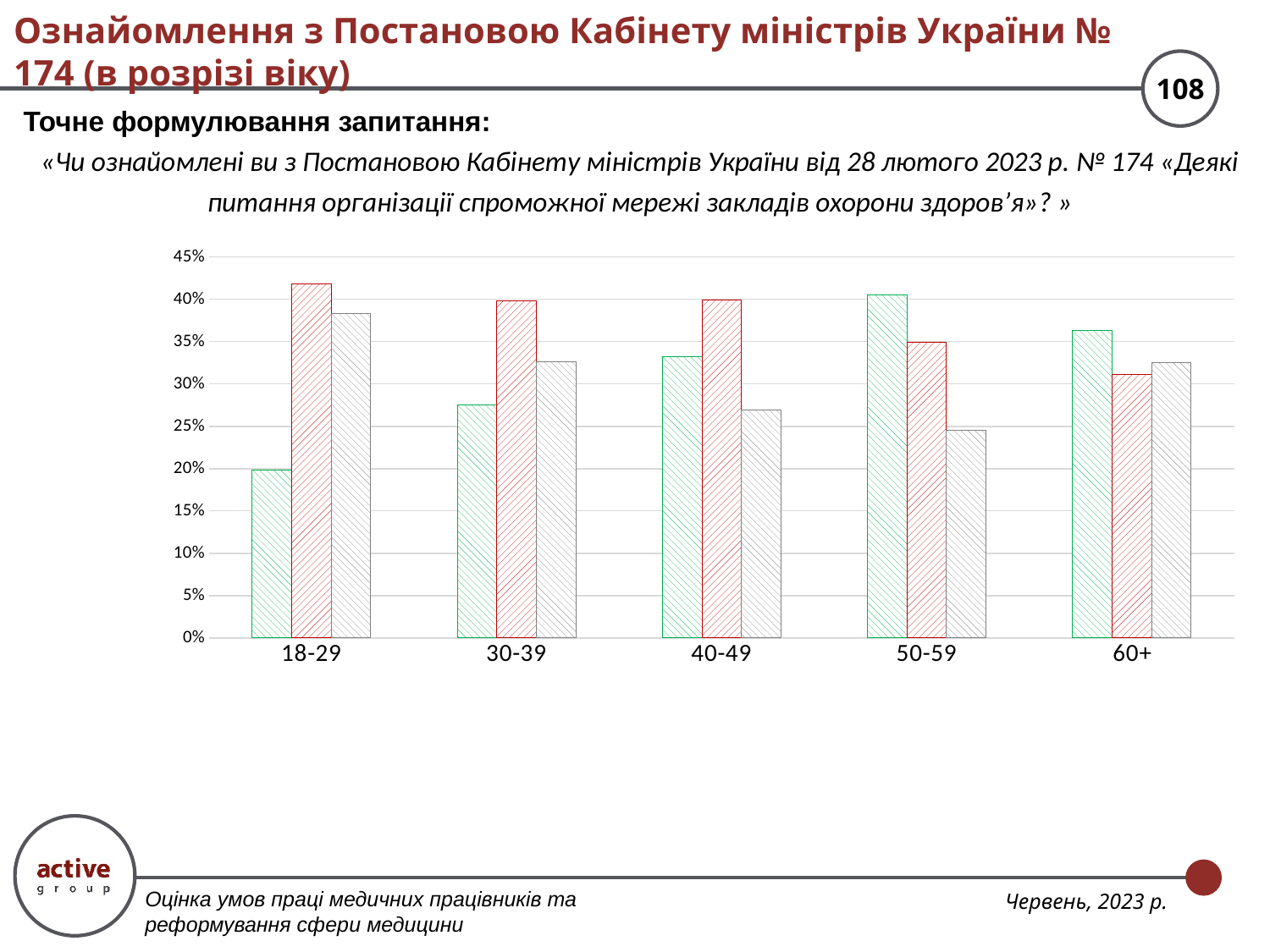
In the 18-29 age group, which bar is taller: the green hatched bar or the red hatched bar? the red hatched bar Is the value of the grey hatched bar for the 50-59 age group greater or less than 30%? less Is the value of the green hatched bar for the 18-29 age group greater or less than 25%? less What kind of chart is shown on the slide? bar chart How many age groups are shown on the x axis of the chart? 5 Is the value of the green hatched bar for the 50-59 age group greater or less than 35%? greater Which age group has the lowest green hatched bar? 18-29 How many bars are plotted for each age group in the chart? 3 Which age group has the highest green hatched bar? 50-59 Which age group has the lowest red hatched bar? 60+ Do the values of the red hatched bars rise or fall from the 18-29 age group to the 60+ age group? fall